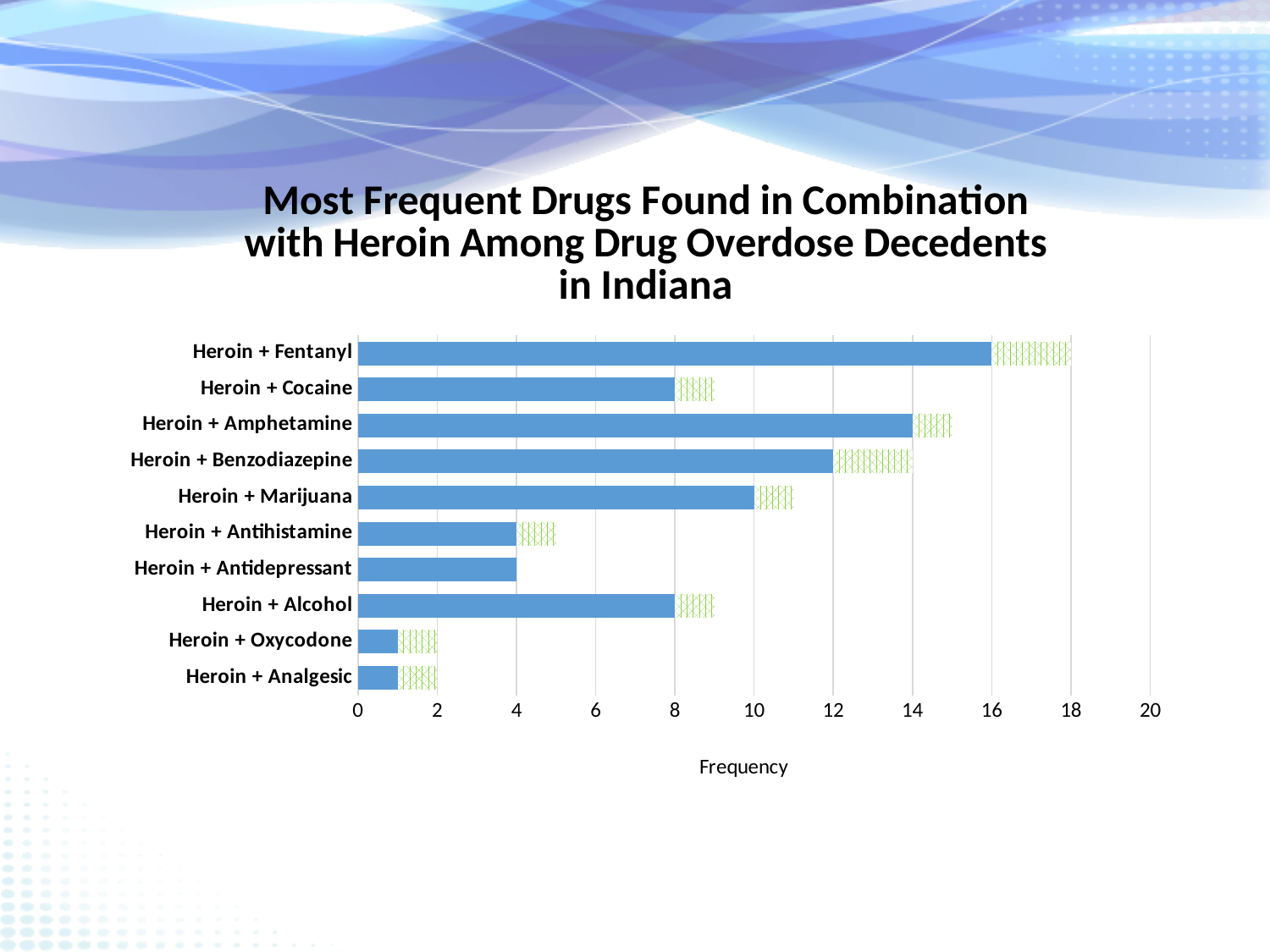
How many drug combination categories are plotted on the chart? 10 At what frequency does the solid blue segment of the Heroin + Fentanyl bar end? 16 At what frequency does the full Heroin + Fentanyl bar (including the hatched segment) end? 18 What kind of chart is shown on the slide? bar chart Which bar is longer overall, Heroin + Amphetamine or Heroin + Benzodiazepine? Heroin + Amphetamine Is the total length of the Heroin + Cocaine bar greater or less than 10? less At what frequency does the solid blue segment of the Heroin + Marijuana bar end? 10 At what frequency does the full Heroin + Benzodiazepine bar (including the hatched segment) end? 14 What is the label of the horizontal axis? Frequency At what frequency does the solid blue segment of the Heroin + Benzodiazepine bar end? 12 Which drug combination has the longest bar on the chart? Heroin + Fentanyl What is the difference between the solid blue segments of Heroin + Fentanyl (16) and Heroin + Cocaine (8)? 8